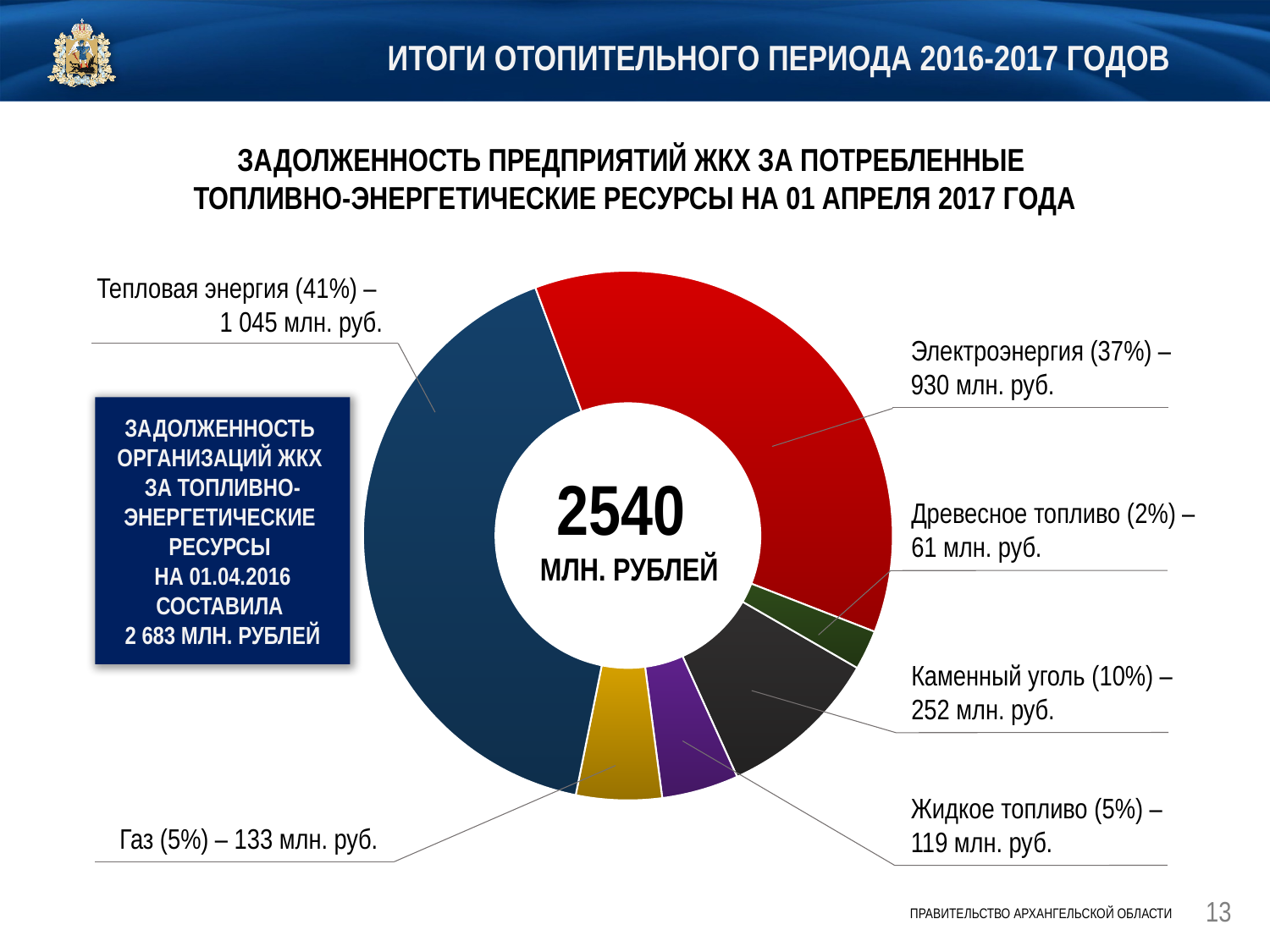
What is the debt value for Электроэнергия? 930 млн. руб. Which category has the largest debt? Тепловая энергия What share of the pie does Древесное топливо represent? 2% Which is larger, the debt for Газ or for Жидкое топливо? Газ What type of chart is shown on the slide? Pie (donut) chart What is the difference between the debt for Тепловая энергия and Электроэнергия? 115 млн. руб. What share of the pie does Жидкое топливо represent? 5% Which category has the smallest debt? Древесное топливо What total value is shown in the centre of the donut chart? 2540 млн. рублей How many categories does the pie chart show? 6 What is the debt value for Каменный уголь? 252 млн. руб. What is the debt value for Тепловая энергия? 1 045 млн. руб.